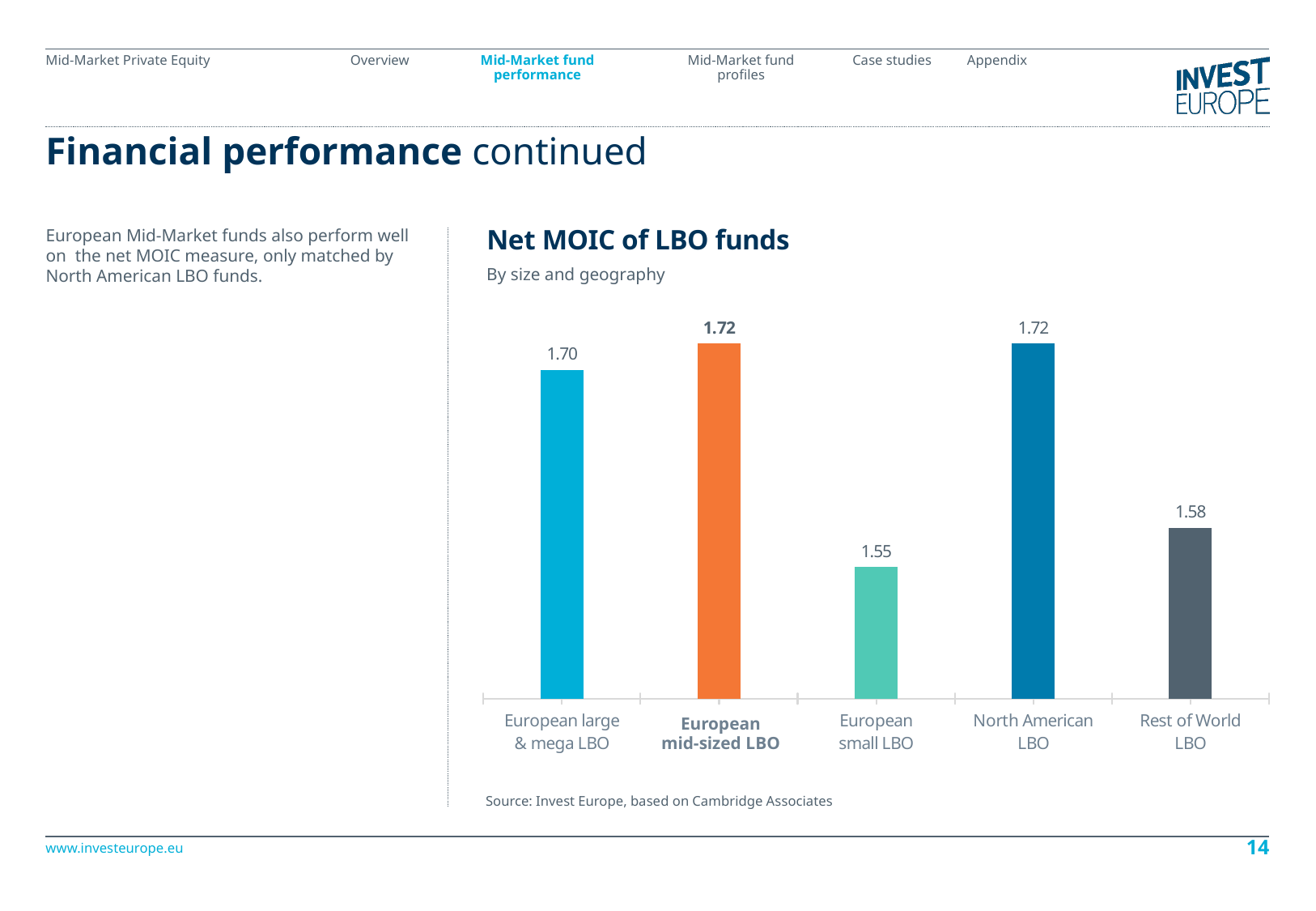
What is the difference in net MOIC between European mid-sized LBO and European large & mega LBO funds? 0.02 What is the net MOIC for European large & mega LBO funds? 1.70 What is the net MOIC for European mid-sized LBO funds? 1.72 Which has a higher net MOIC, Rest of World LBO or European small LBO? Rest of World LBO Which category has the lowest net MOIC? European small LBO What is the net MOIC for Rest of World LBO funds? 1.58 What type of chart is shown on the slide? Bar chart What is the difference in net MOIC between North American LBO and European small LBO funds? 0.17 What is the net MOIC for European small LBO funds? 1.55 Which has a higher net MOIC, European large & mega LBO or Rest of World LBO? European large & mega LBO What is the title of the chart? Net MOIC of LBO funds How many categories are shown in the chart? 5